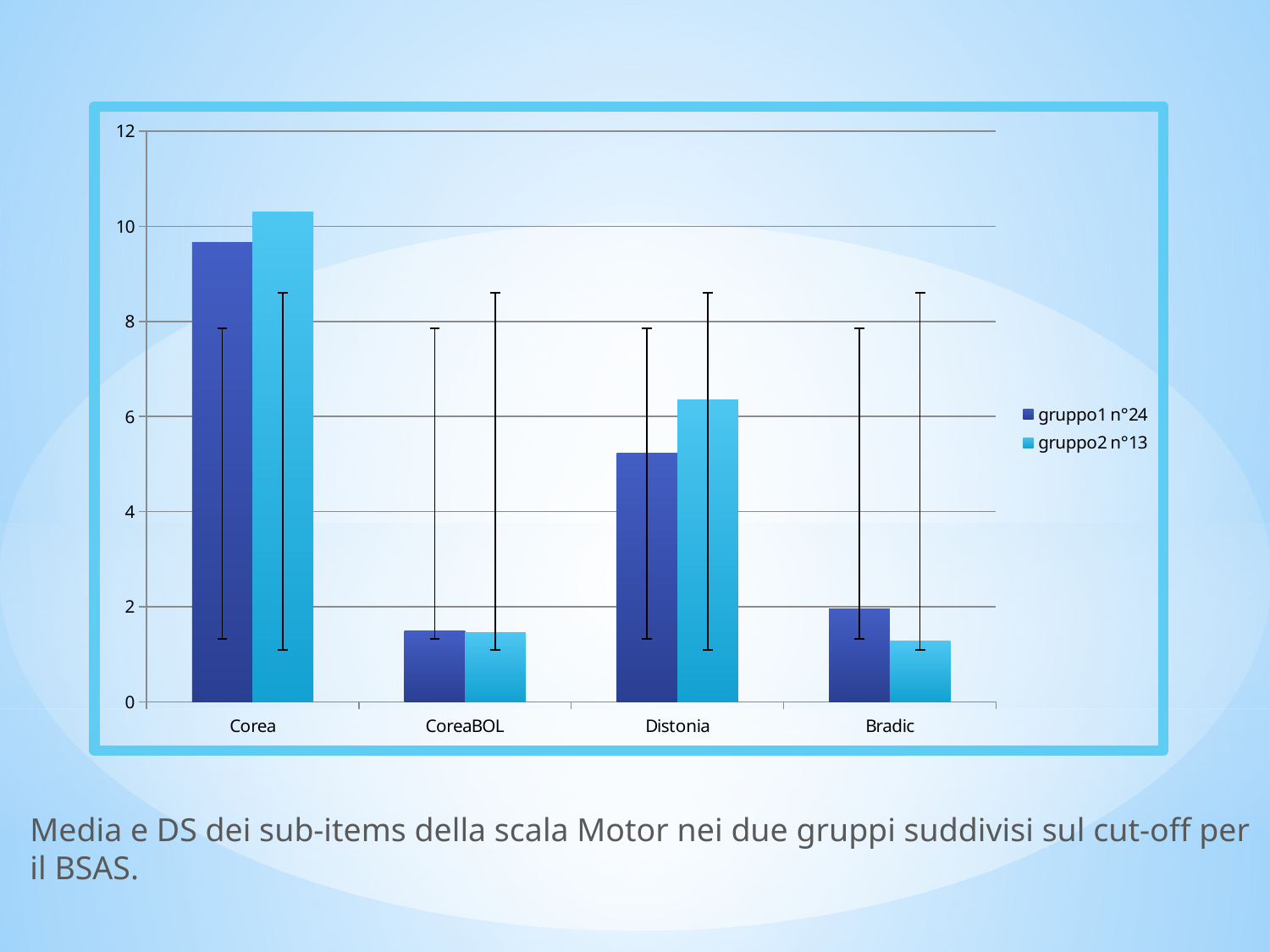
Which category has the highest value for gruppo2 n°13? Corea Which category has the highest value for gruppo1 n°24? Corea For Bradic, which series has the larger value, gruppo1 n°24 or gruppo2 n°13? gruppo1 n°24 How many categories are shown on the x axis of the chart? 4 What kind of chart is shown on the slide? bar chart For Distonia, which series has the larger value, gruppo1 n°24 or gruppo2 n°13? gruppo2 n°13 Is the value for gruppo1 n°24 in Distonia greater or less than 4? greater Is the value for gruppo2 n°13 in Corea greater or less than 10? greater How many series does the chart's legend list? 2 Which category has the lowest value for gruppo1 n°24? CoreaBOL What are the two entries listed in the chart's legend? gruppo1 n°24 and gruppo2 n°13 Is the value for gruppo2 n°13 in Bradic greater or less than 2? less